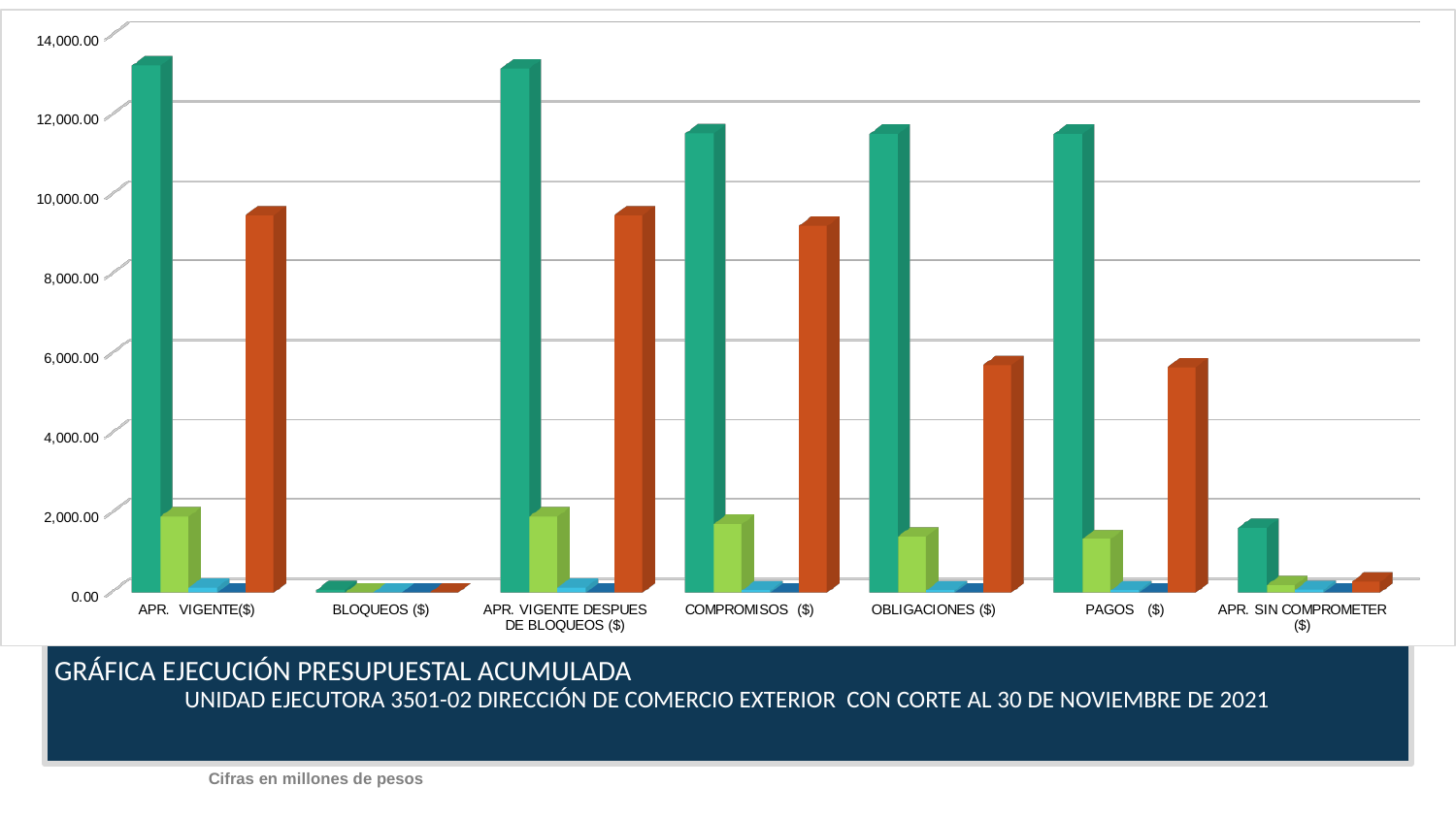
Is the value of the orange bar for OBLIGACIONES ($) greater or less than 6,000.00? less According to the note below the chart, in what units are the figures expressed? Millones de pesos How many categories are shown along the x axis of the chart? 7 Which category has the lowest teal bar? BLOQUEOS ($) Which is larger: the orange bar for COMPROMISOS ($) or the orange bar for PAGOS ($)? COMPROMISOS ($) Is the value of the teal bar for APR. SIN COMPROMETER ($) greater or less than 2,000.00? less Is the value of the teal bar for COMPROMISOS ($) greater or less than 10,000.00? greater What kind of chart is shown on the slide? Bar chart For COMPROMISOS ($), which is larger: the teal bar or the orange bar? The teal bar